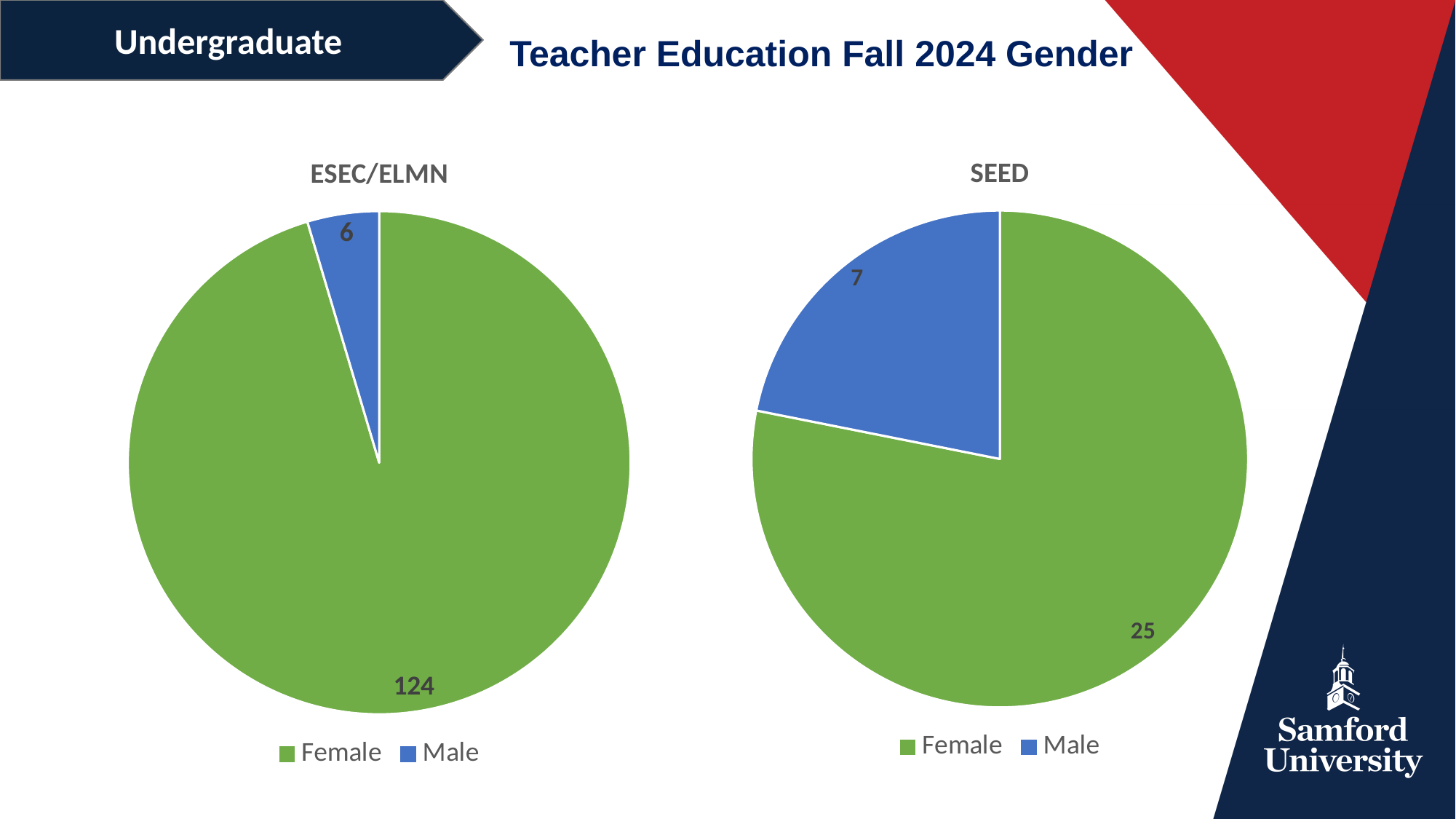
In the SEED chart, which category has the smallest slice? Male In the SEED chart, what is the total of all slices? 32 What kind of chart is the ESEC/ELMN chart? Pie chart In the ESEC/ELMN chart, what is the value for Female? 124 In the ESEC/ELMN chart, what is the difference between the Female and Male values? 118 In the SEED chart, what is the value for Male? 7 In the ESEC/ELMN chart, which category has the largest slice? Female How many categories does the legend of the SEED chart list? 2 Which is larger: the Male value in the ESEC/ELMN chart or the Male value in the SEED chart? SEED In the ESEC/ELMN chart, what is the value for Male? 6 In the SEED chart, what is the value for Female? 25 In the SEED chart, what is the difference between the Female and Male values? 18